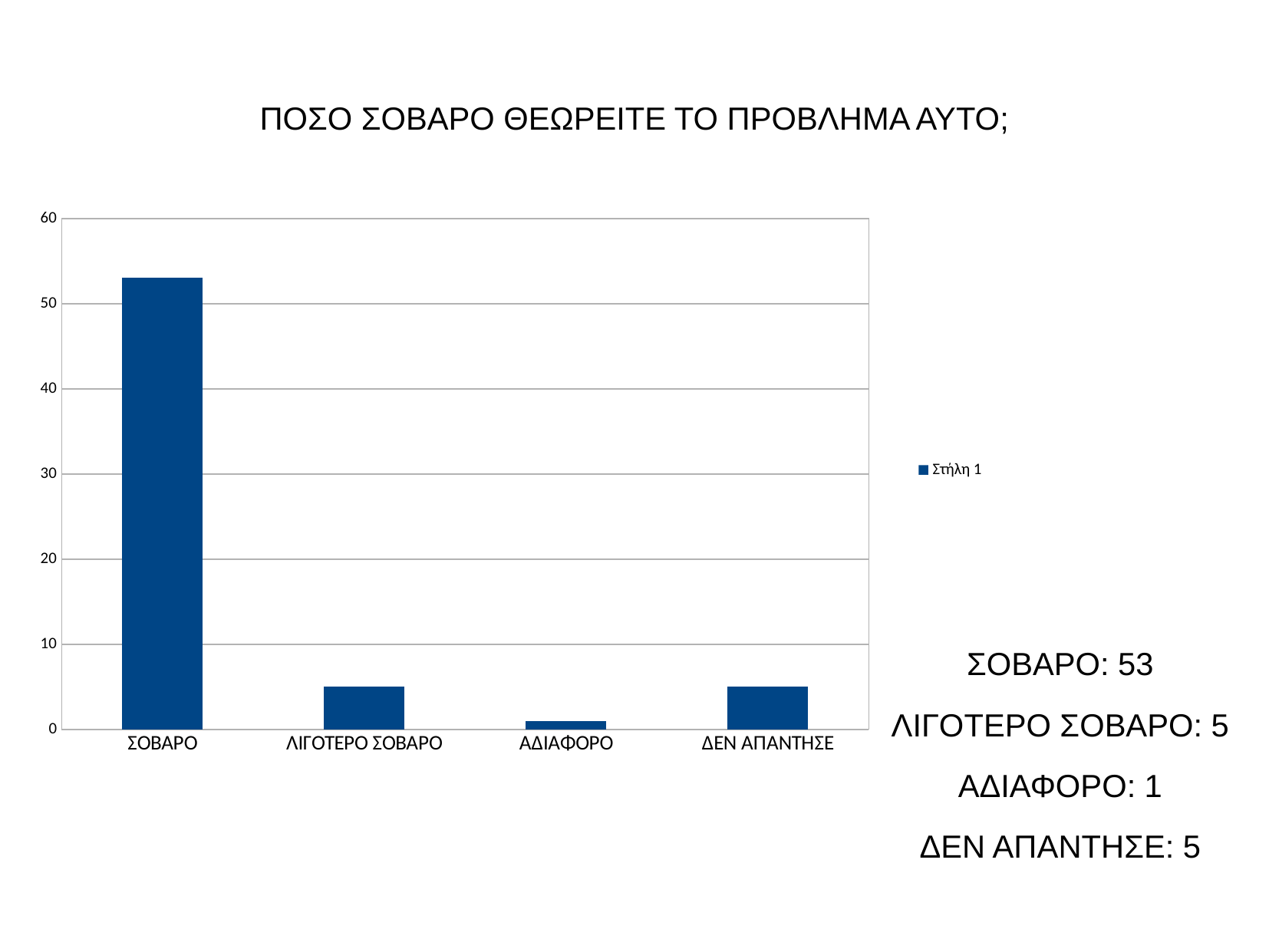
Which category has the highest value? ΣΟΒΑΡΟ What is the value for ΑΔΙΑΦΟΡΟ? 1 What is the value for ΔΕΝ ΑΠΑΝΤΗΣΕ? 5 What is the value for ΛΙΓΟΤΕΡΟ ΣΟΒΑΡΟ? 5 Is the value for ΣΟΒΑΡΟ greater or less than 50? greater What is the difference between the values for ΔΕΝ ΑΠΑΝΤΗΣΕ and ΑΔΙΑΦΟΡΟ? 4 What is the difference between the values for ΣΟΒΑΡΟ and ΛΙΓΟΤΕΡΟ ΣΟΒΑΡΟ? 48 How many categories are shown on the x axis? 4 Which category has the lowest value? ΑΔΙΑΦΟΡΟ Which is larger, the value for ΣΟΒΑΡΟ or the value for ΑΔΙΑΦΟΡΟ? ΣΟΒΑΡΟ What kind of chart is shown on the slide? bar chart What is the value for ΣΟΒΑΡΟ? 53